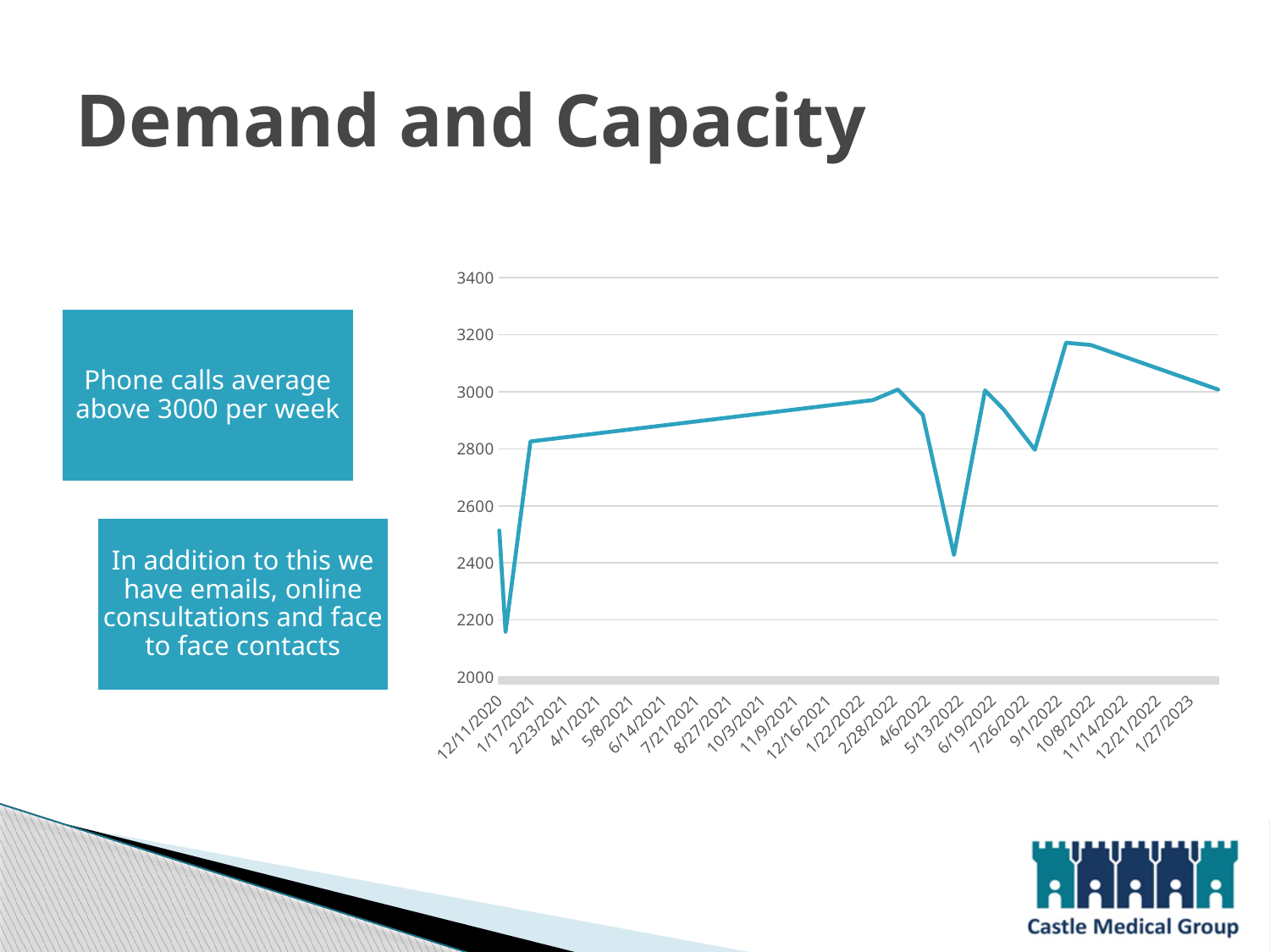
Is the highest point on the line greater or less than 3000? greater What is the highest value shown on the y axis of the chart? 3400 Is the lowest point on the line greater or less than 2200? less Is the value of the line around 10/8/2022 greater or less than 3000? greater Which is larger: the value of the line near 10/8/2022 or the value near 1/17/2021? 10/8/2022 How many date labels are shown along the x axis of the chart? 22 What is the first date label on the x axis of the chart? 12/11/2020 Overall, does the line rise or fall from the first date to the last date on the x axis? rise What kind of chart is shown on the slide? line chart How many lines (series) are plotted on the chart? 1